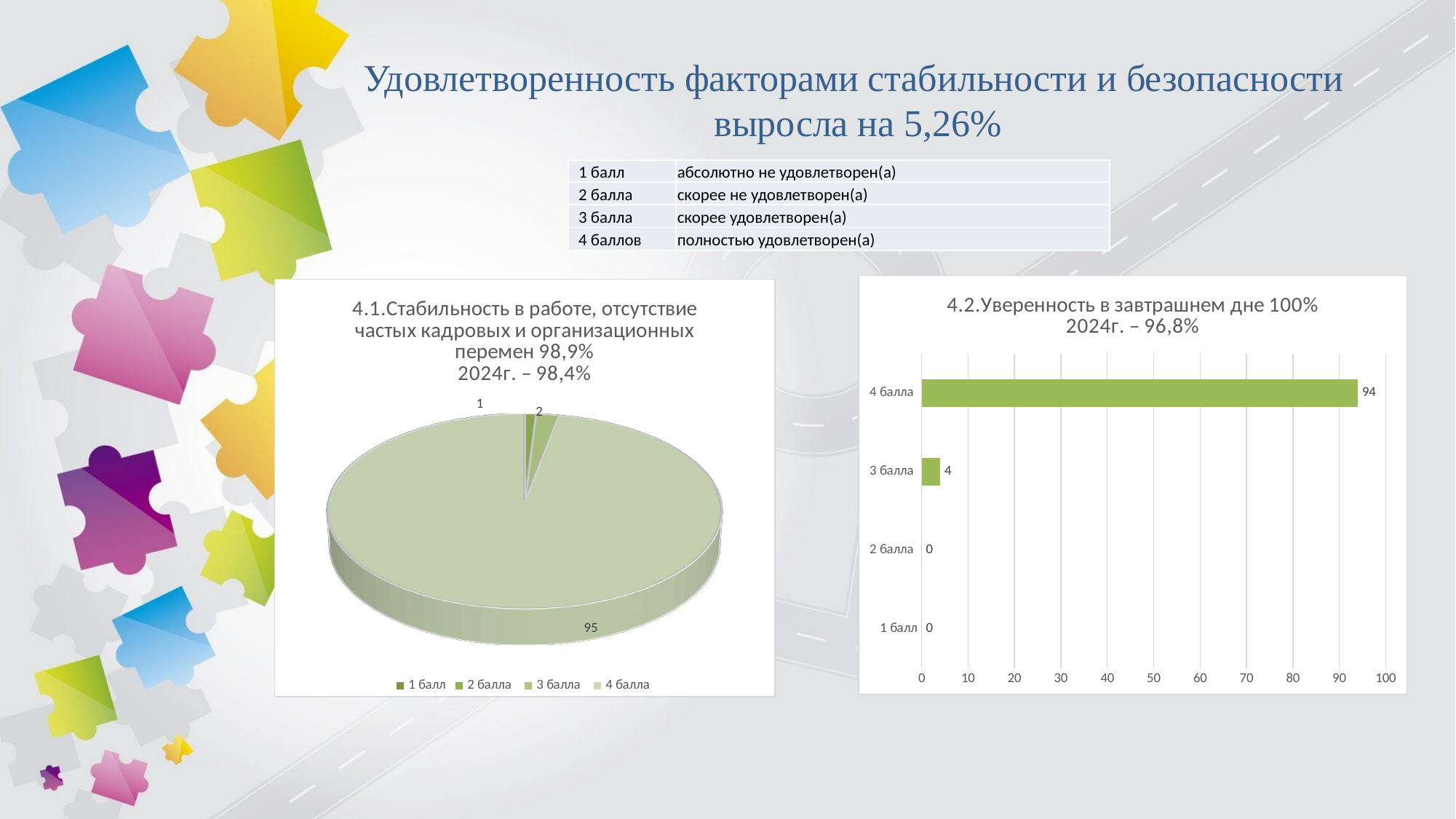
In the chart "4.2.Уверенность в завтрашнем дне", what is the difference between the values for 4 балла and 3 балла? 90 How many entries does the legend of the pie chart "4.1.Стабильность в работе" list? 4 In the chart "4.2.Уверенность в завтрашнем дне", which category has the highest value? 4 балла In the chart "4.2.Уверенность в завтрашнем дне", what is the value for 4 балла? 94 In the pie chart "4.1.Стабильность в работе", what value is labelled on the largest slice? 95 What type of chart is the chart titled "4.1.Стабильность в работе"? pie chart In the chart "4.2.Уверенность в завтрашнем дне", which is larger, the value for 4 балла or the value for 3 балла? 4 балла In the chart "4.2.Уверенность в завтрашнем дне", is the value for 4 балла greater or less than 90? greater How many categories are shown in the chart "4.2.Уверенность в завтрашнем дне"? 4 In the chart "4.2.Уверенность в завтрашнем дне", what is the value for 3 балла? 4 In the chart "4.2.Уверенность в завтрашнем дне", what is the value for 1 балл? 0 What type of chart is the chart titled "4.2.Уверенность в завтрашнем дне"? bar chart